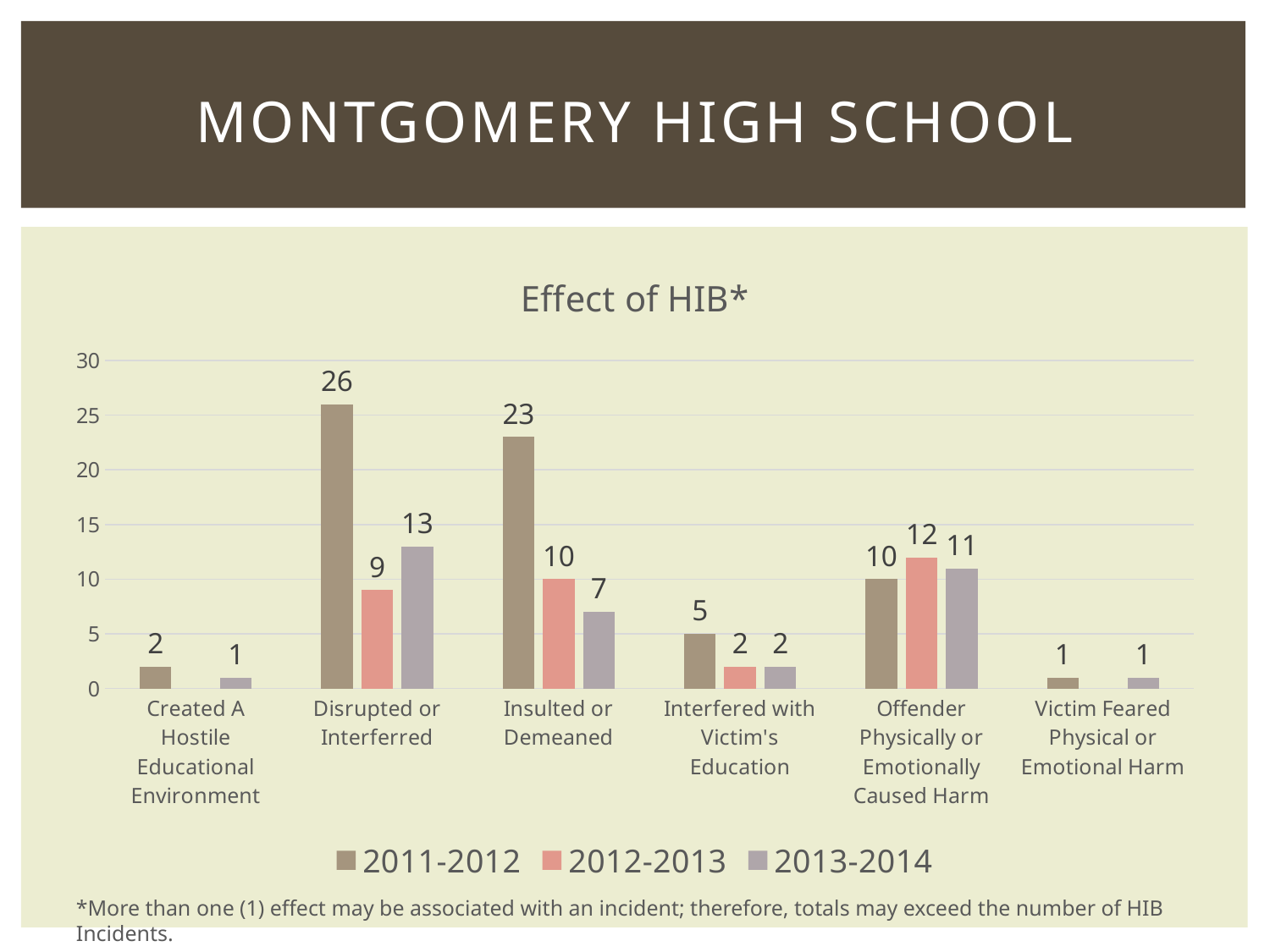
What is the difference between the 2011-2012 and 2012-2013 values in the Disrupted or Interferred category? 17 How many series does the legend list? 3 How many categories are shown on the x axis? 6 What is the value for 2012-2013 in the Offender Physically or Emotionally Caused Harm category? 12 What is the difference between the 2011-2012 and 2013-2014 values in the Insulted or Demeaned category? 16 Which category has the lowest value for the 2011-2012 series? Victim Feared Physical or Emotional Harm What is the value for 2011-2012 in the Disrupted or Interferred category? 26 Which category has the highest value for the 2011-2012 series? Disrupted or Interferred What is the value for 2013-2014 in the Insulted or Demeaned category? 7 For 2011-2012, which is larger: Disrupted or Interferred or Insulted or Demeaned? Disrupted or Interferred In the Offender Physically or Emotionally Caused Harm category, which series has the highest value? 2012-2013 What type of chart is shown on the slide? Bar chart